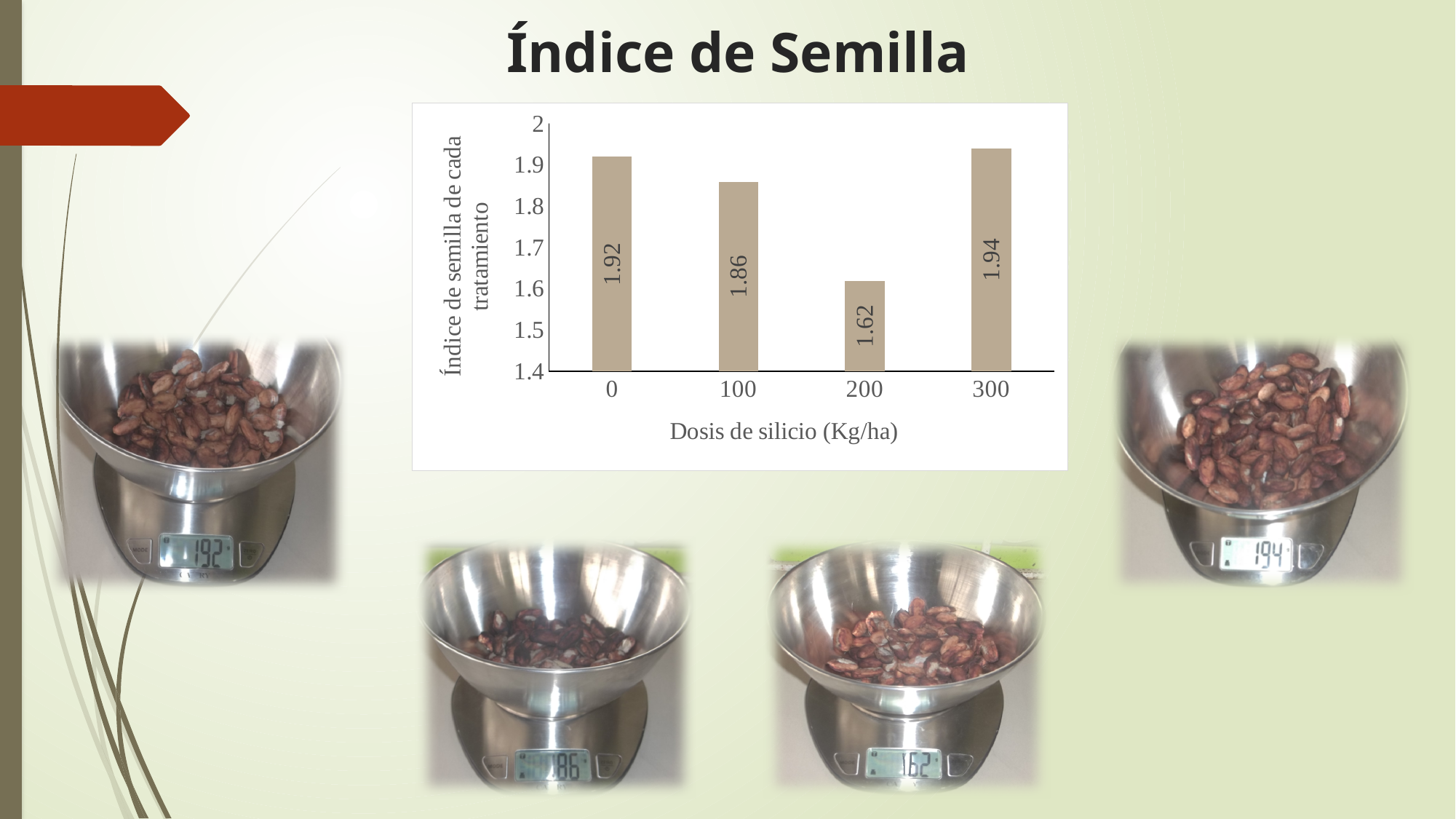
What is the seed index value for the 0 Kg/ha silicon dose? 1.92 Which has a larger seed index, the 0 Kg/ha dose or the 100 Kg/ha dose? 0 Kg/ha How many silicon doses are shown on the x axis of the chart? 4 What is the seed index value for the 100 Kg/ha silicon dose? 1.86 Which silicon dose has the lowest seed index? 200 Is the seed index for the 200 Kg/ha dose greater or less than 1.7? less What kind of chart is shown on the slide? bar chart What is the seed index value for the 200 Kg/ha silicon dose? 1.62 Which silicon dose has the highest seed index? 300 What is the difference between the seed index at 300 Kg/ha and at 200 Kg/ha? 0.32 What is the x-axis label of the chart? Dosis de silicio (Kg/ha) What is the seed index value for the 300 Kg/ha silicon dose? 1.94